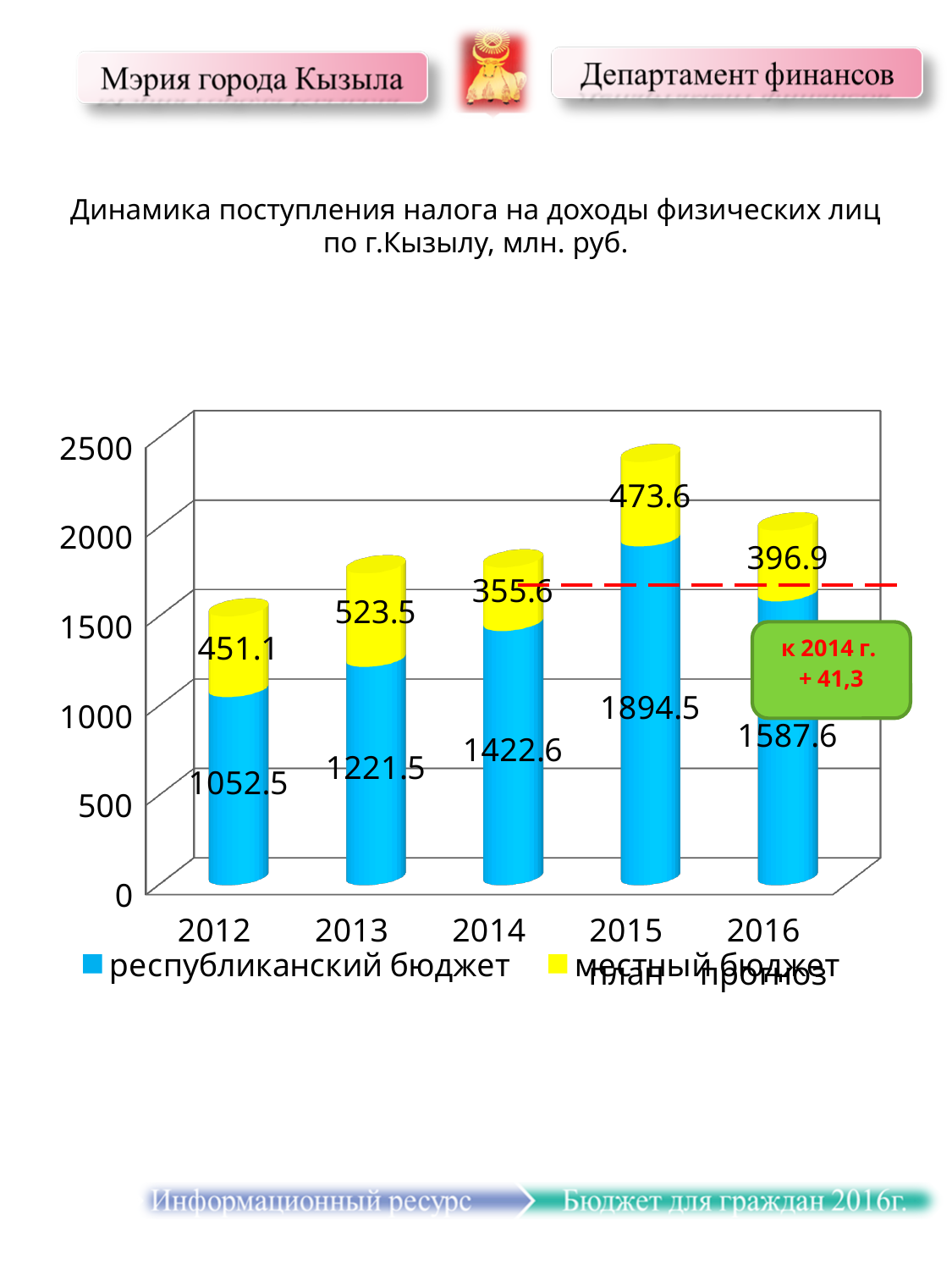
What is the difference between the республиканский бюджет values for 2015 and 2016? 306.9 How many years are shown on the x axis? 5 Which year has the lowest value for местный бюджет? 2014 What is the total of the stacked bar for 2012? 1503.6 Which is larger: местный бюджет in 2012 or in 2015? 2015 What is the total of the stacked bar for 2015? 2368.1 How many series does the legend list? 2 What is the value of местный бюджет for 2016? 396.9 Which year has the highest value for республиканский бюджет? 2015 What is the value of республиканский бюджет for 2015? 1894.5 What is the value of местный бюджет for 2013? 523.5 What kind of chart is shown on the slide? Stacked bar chart